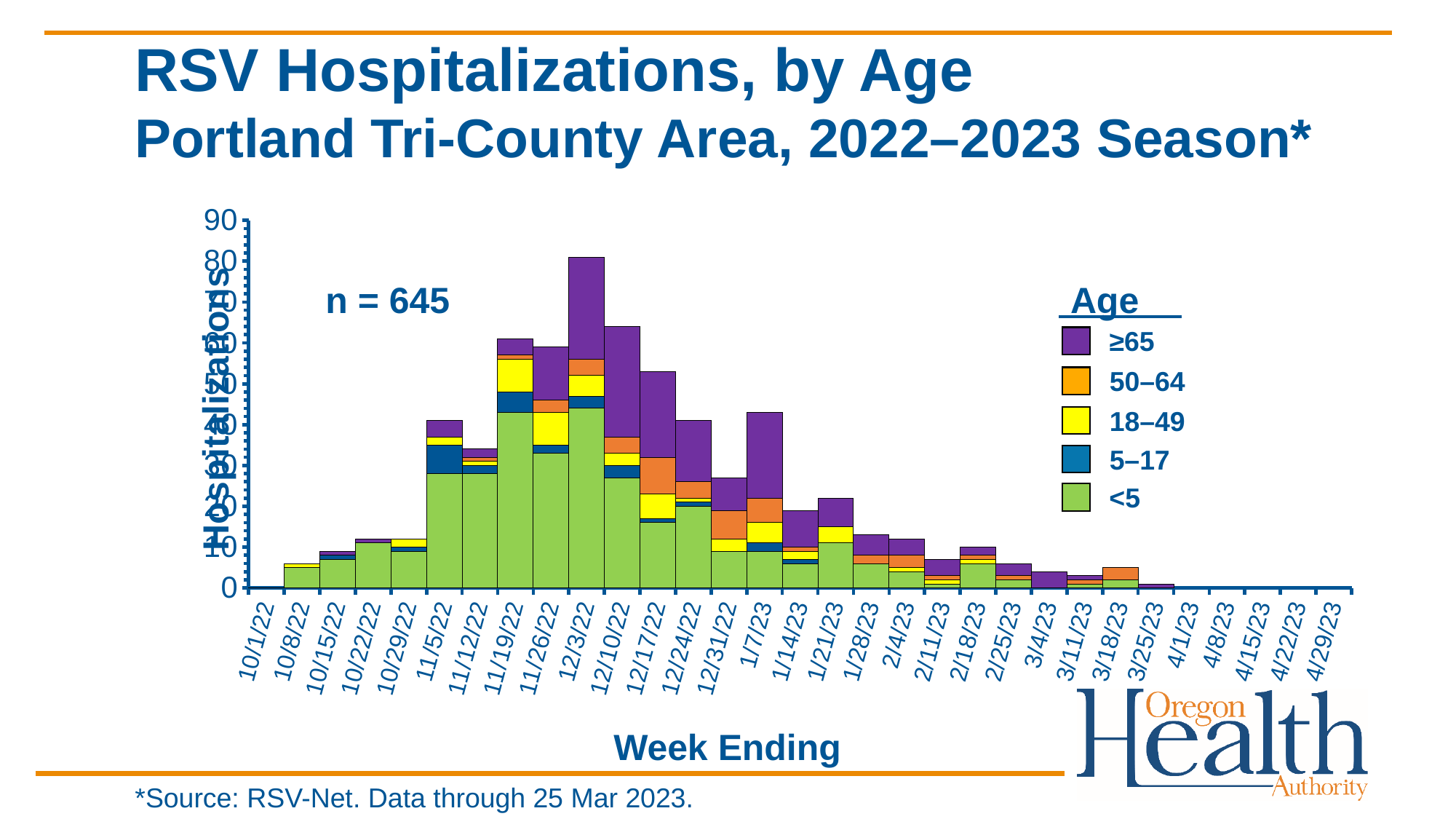
Do total hospitalizations generally rise or fall from the week ending 12/3/22 to the week ending 3/25/23? fall Which week ending has the highest total number of RSV hospitalizations? 12/3/22 Which week has more total hospitalizations, the week ending 12/3/22 or the week ending 12/10/22? 12/3/22 Which age group is shown in green at the bottom of each stacked bar? <5 Is the total number of hospitalizations for the week ending 11/19/22 greater or less than 50? greater What kind of chart is shown on the slide? Stacked bar chart What total sample size (n) is printed on the chart? n = 645 Is the total number of hospitalizations for the week ending 1/7/23 greater or less than 30? greater Which week has more total hospitalizations, the week ending 12/31/22 or the week ending 1/7/23? 1/7/23 Is the total number of hospitalizations for the week ending 12/3/22 greater or less than 70? greater How many age groups does the legend list? 5